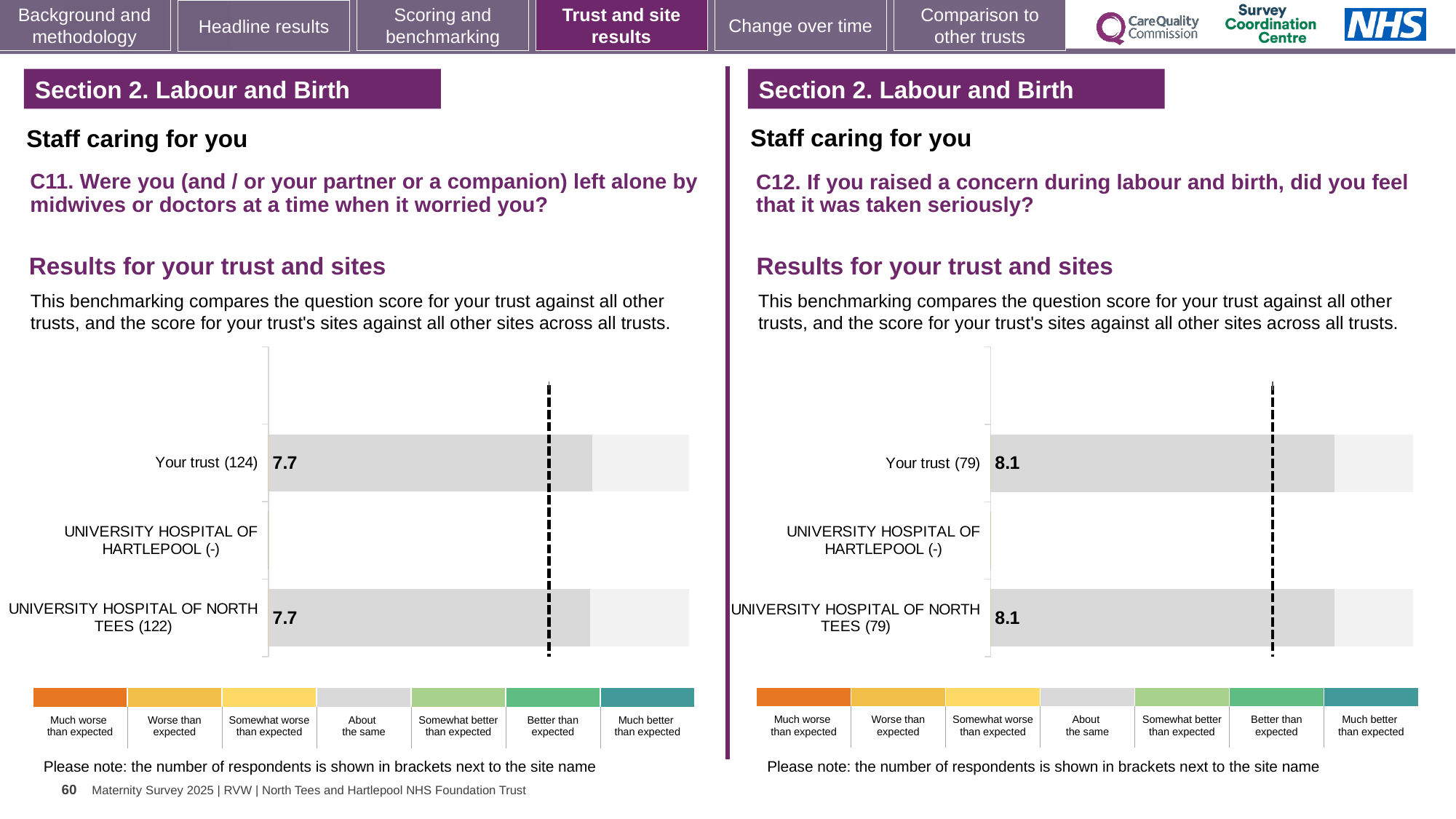
In the right chart (C12), is the score for Your trust greater or less than the score for Your trust in the left chart (C11)? greater In the right chart (C12), what is the score for Your trust? 8.1 In the right chart (C12), how many respondents are shown in brackets for University Hospital of North Tees? 79 In the left chart (C11), which category has no bar plotted? UNIVERSITY HOSPITAL OF HARTLEPOOL (-) In the left chart (C11), how many respondents are shown in brackets for Your trust? 124 What type of chart is used on the right (C12)? Bar chart How many benchmark bands are shown in the colour key below the right chart (C12)? 7 How many site/trust categories are listed on the left chart (C11)? 3 In the left chart (C11), what is the difference between the score for Your trust and the score for University Hospital of North Tees? 0 In the left chart (C11), what is the score for University Hospital of North Tees? 7.7 In the left chart (C11), what is the score for Your trust? 7.7 In the right chart (C12), what is the score for University Hospital of North Tees? 8.1